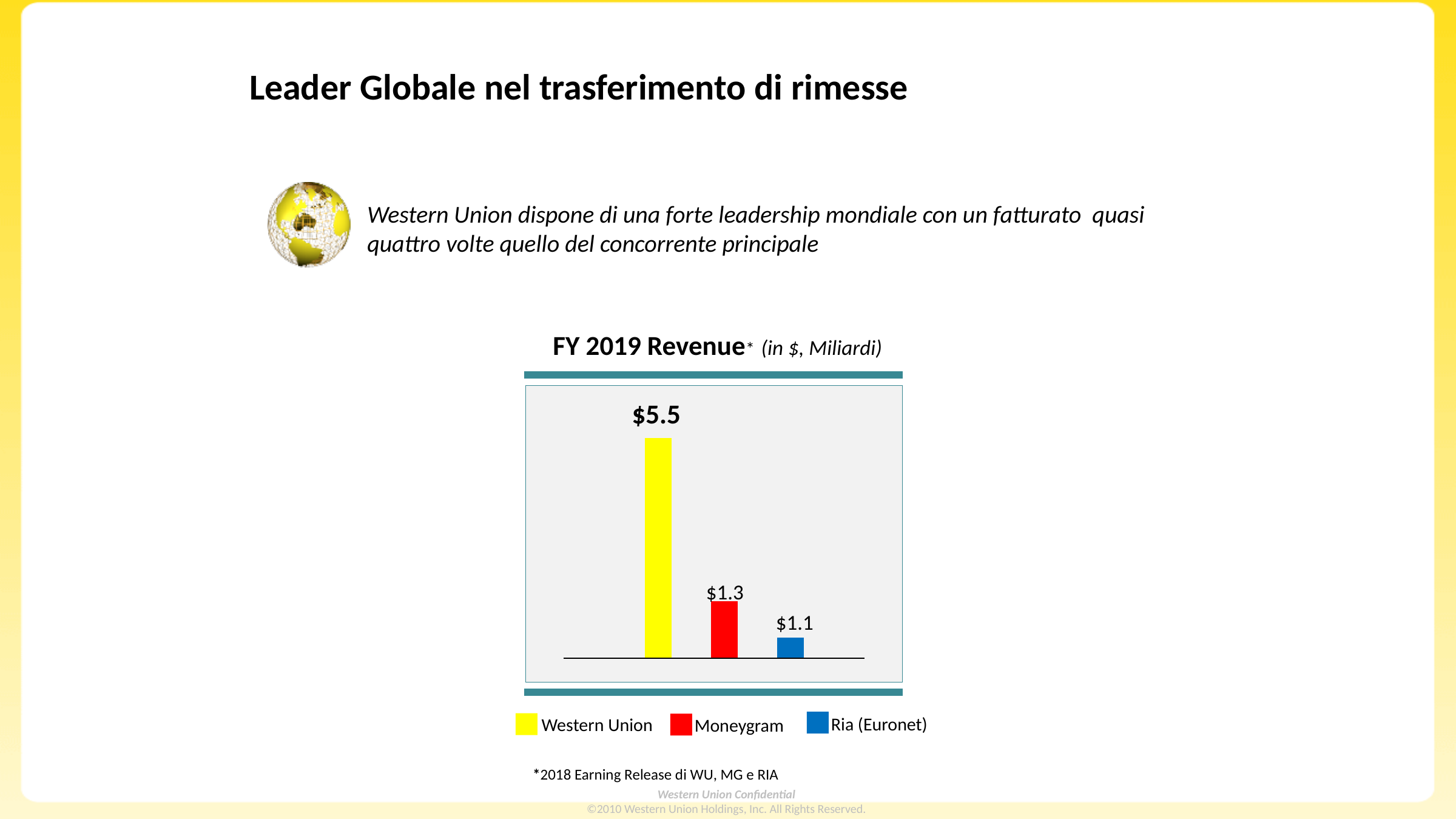
What is the FY 2019 revenue shown for Western Union? $5.5 What is the FY 2019 revenue shown for Ria (Euronet)? $1.1 What type of chart is used to show FY 2019 Revenue? Bar chart What is the FY 2019 revenue shown for Moneygram? $1.3 How many entries does the legend of the FY 2019 Revenue chart list? 3 What is the difference between Western Union's and Moneygram's FY 2019 revenue? $4.2 Which company has the highest FY 2019 revenue in the chart? Western Union What colour is the bar for Moneygram in the FY 2019 Revenue chart? Red How many companies are shown in the FY 2019 Revenue chart? 3 What is the difference between Moneygram's and Ria (Euronet)'s FY 2019 revenue? $0.2 Which has the larger FY 2019 revenue, Moneygram or Ria (Euronet)? Moneygram Which company has the lowest FY 2019 revenue in the chart? Ria (Euronet)